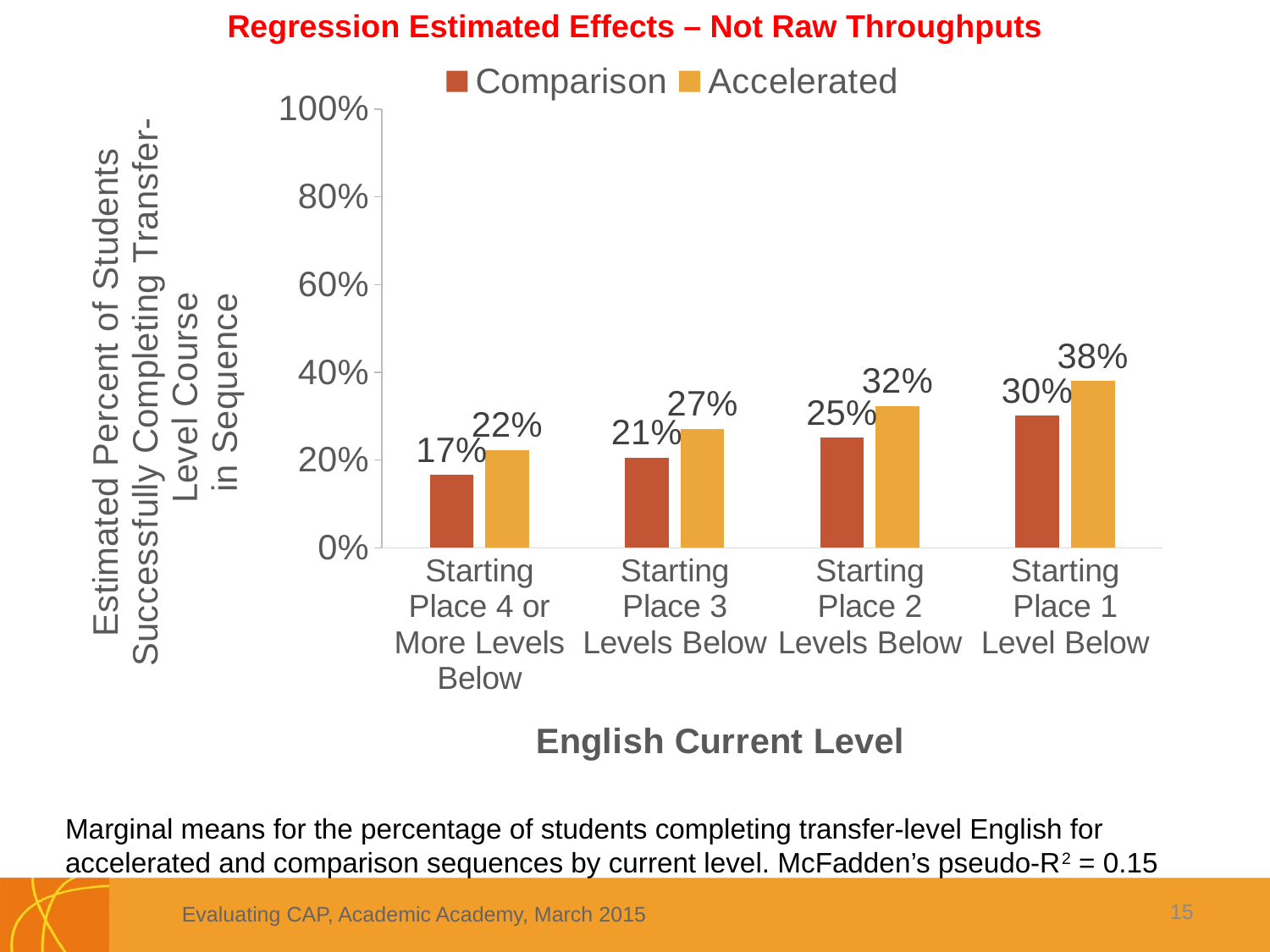
Which is larger for Starting Place 2 Levels Below, the Comparison value or the Accelerated value? Accelerated What is the Comparison value for Starting Place 4 or More Levels Below? 17% How many series does the legend list? 2 Is the Accelerated value for Starting Place 1 Level Below greater or less than 40%? less What is the Accelerated value for Starting Place 1 Level Below? 38% What is the difference between the Accelerated and Comparison values for Starting Place 3 Levels Below? 6% Do the Comparison values rise or fall from left to right along the x axis? rise Which category has the lowest Comparison value? Starting Place 4 or More Levels Below What is the Comparison value for Starting Place 2 Levels Below? 25% How many categories are shown on the x axis? 4 Which category has the highest Accelerated value? Starting Place 1 Level Below What kind of chart is shown on the slide? bar chart